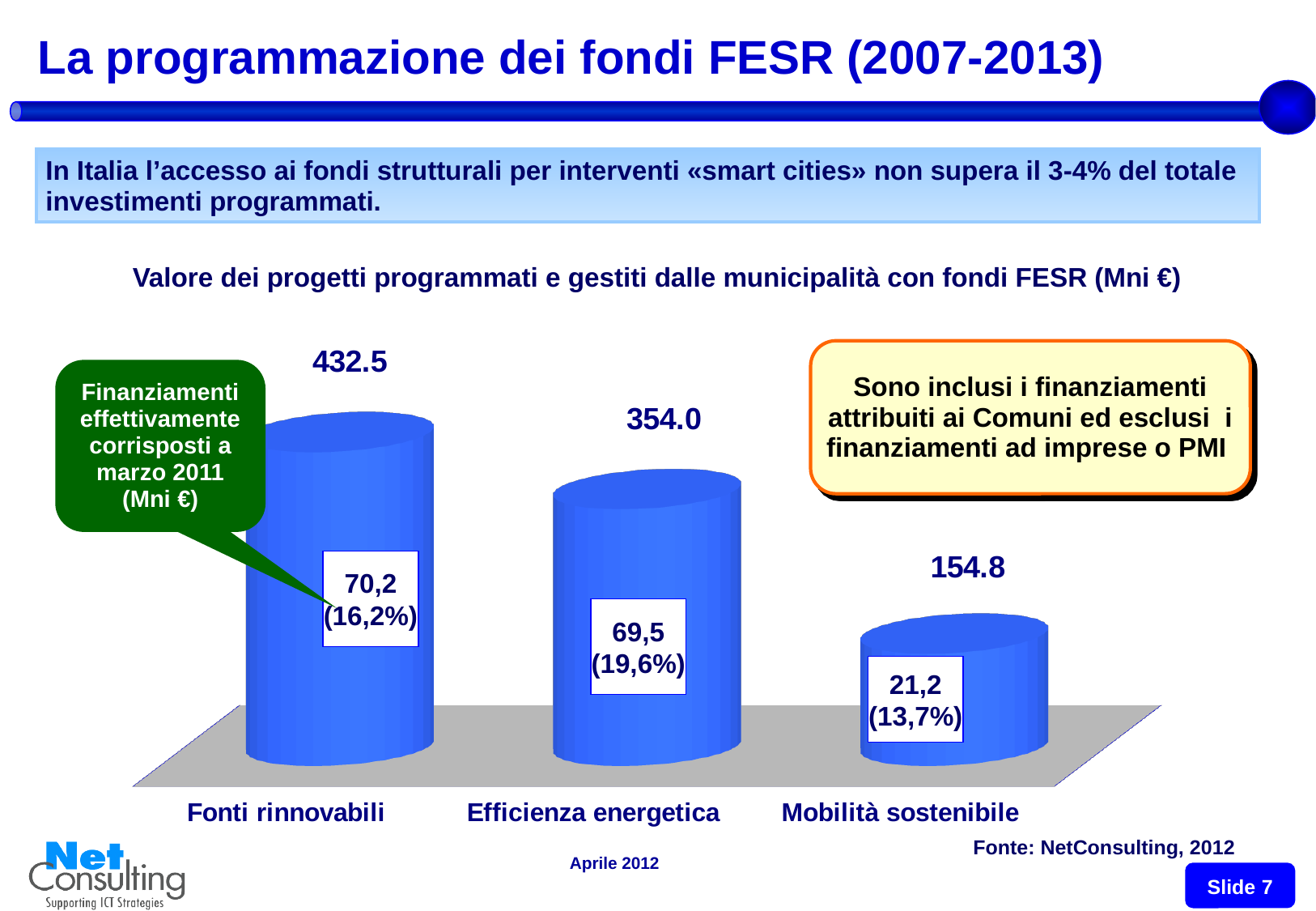
What kind of chart is shown on the slide? Bar chart How many categories are shown in the chart? 3 Which category has the highest value of programmed projects? Fonti rinnovabili Which is larger, the programmed value for Efficienza energetica or for Mobilità sostenibile? Efficienza energetica What is the value of programmed FESR projects for Efficienza energetica? 354.0 What is the value of programmed FESR projects for Mobilità sostenibile? 154.8 What is the difference between the programmed values for Efficienza energetica and Mobilità sostenibile? 199.2 What is the difference between the programmed values for Fonti rinnovabili and Efficienza energetica? 78.5 Which category has the lowest value of programmed projects? Mobilità sostenibile What is the value of programmed FESR projects for Fonti rinnovabili? 432.5 What amount of funding was actually disbursed by March 2011 for Efficienza energetica, as shown in the box on the bar? 69,5 (19,6%) What is the title of the chart? Valore dei progetti programmati e gestiti dalle municipalità con fondi FESR (Mni €)